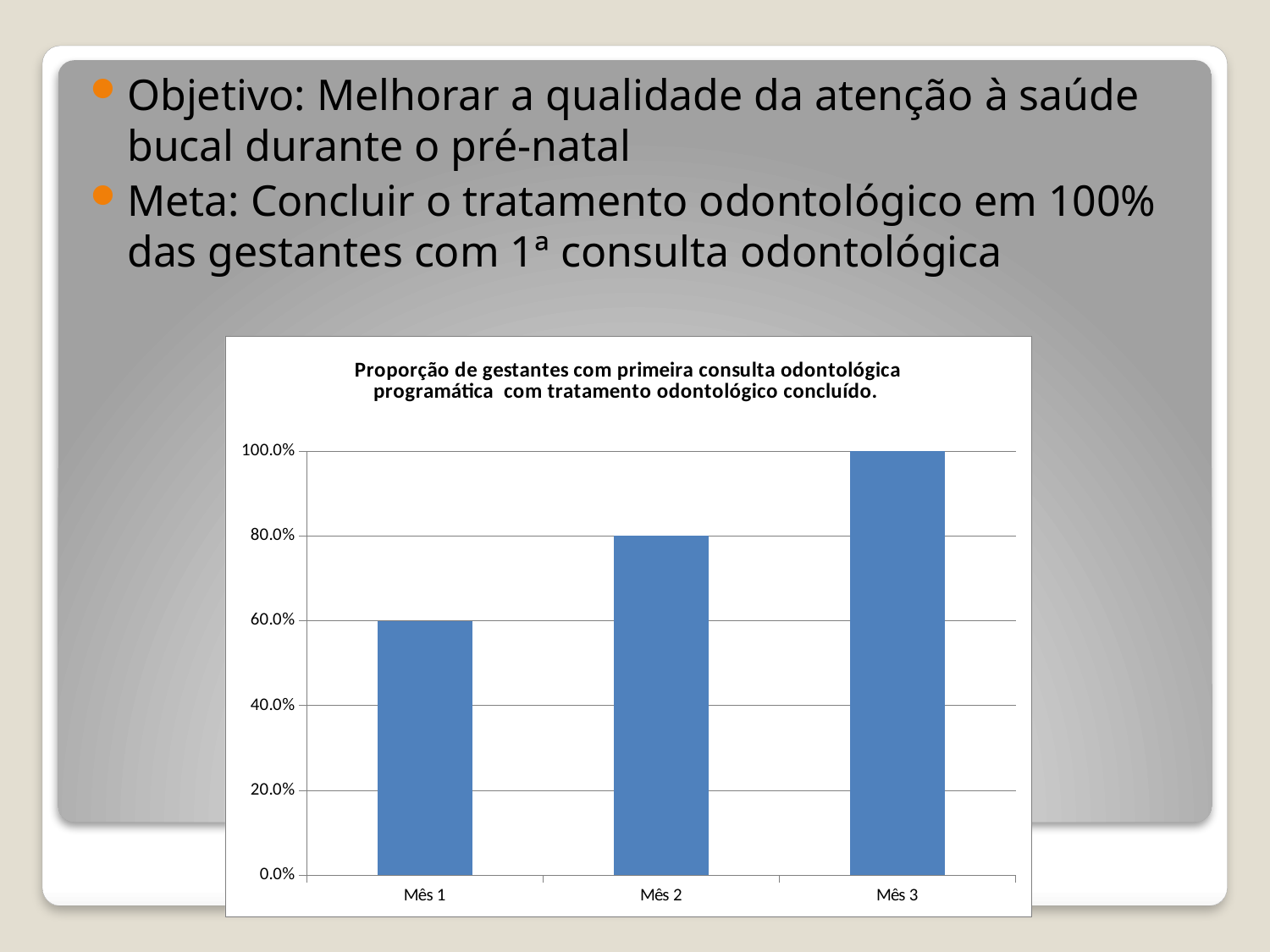
What is the difference between the values for Mês 3 and Mês 1? 40.0% How many categories (months) are plotted on the chart? 3 Which is larger, the value for Mês 2 or the value for Mês 1? Mês 2 What is the value for Mês 2? 80.0% What is the title of the chart? Proporção de gestantes com primeira consulta odontológica programática com tratamento odontológico concluído. What is the difference between the values for Mês 2 and Mês 1? 20.0% What is the value for Mês 3? 100.0% Do the values rise or fall from Mês 1 to Mês 3? rise What type of chart is shown on the slide? bar chart What is the value for Mês 1? 60.0% Which month has the highest value? Mês 3 Which month has the lowest value? Mês 1